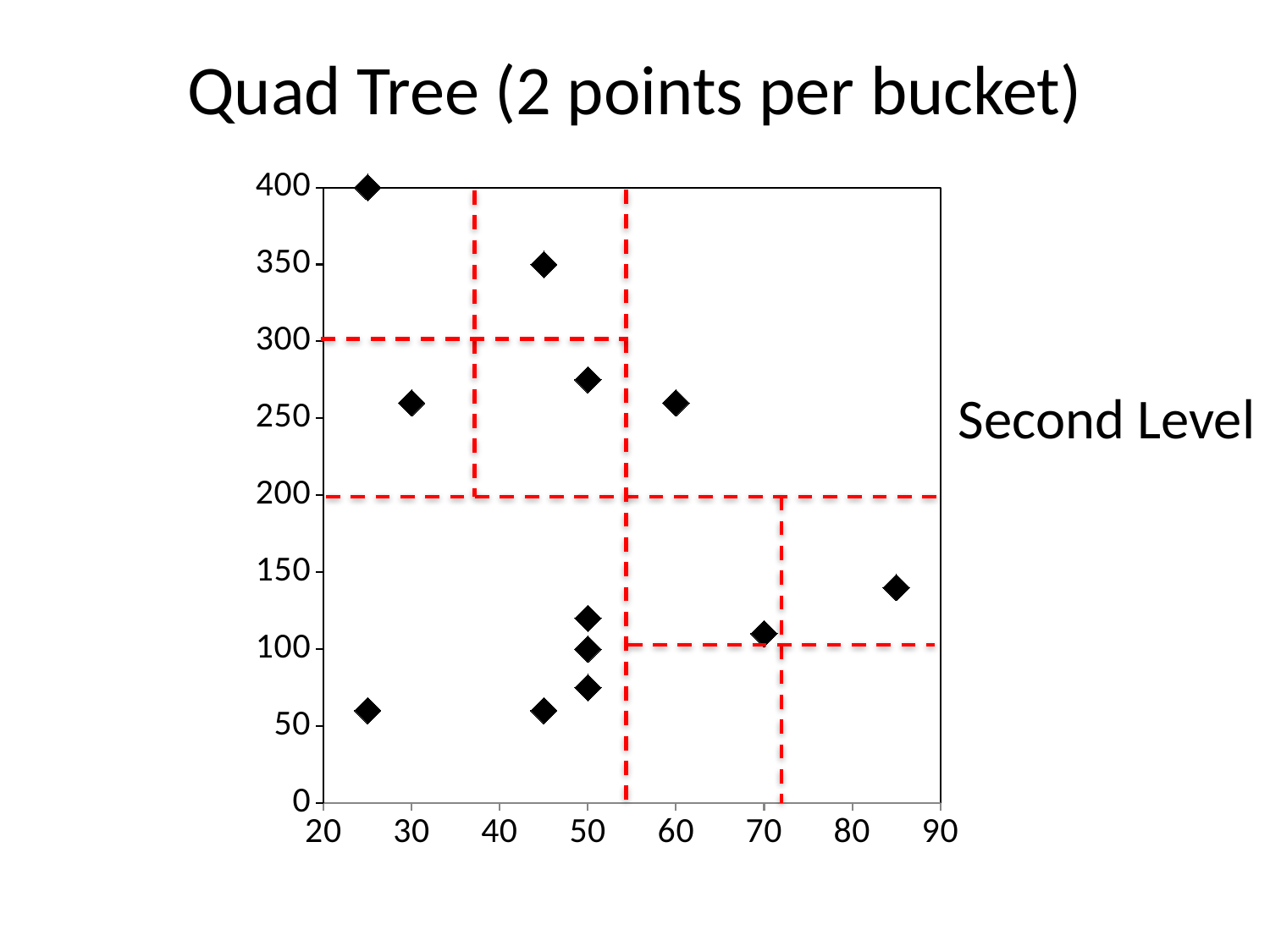
What is the y value of the highest point on the chart? 400 What is the title of the chart on the slide? Quad Tree (2 points per bucket) What colour are the dashed partition lines drawn on the chart? red Is the y value of the point near x=70 greater or less than 150? less Is the y value of the lower-left point near x=25 greater or less than 100? less What kind of chart is shown on the slide? scatter chart Which has the larger y value: the point near x=25 at the top of the chart or the point near x=45 in the upper area? the point near x=25 How many data points are plotted on the chart? 12 Is the x value of the rightmost point greater or less than 80? greater How many points have a y value above 300? 2 How many points have a y value below 200? 7